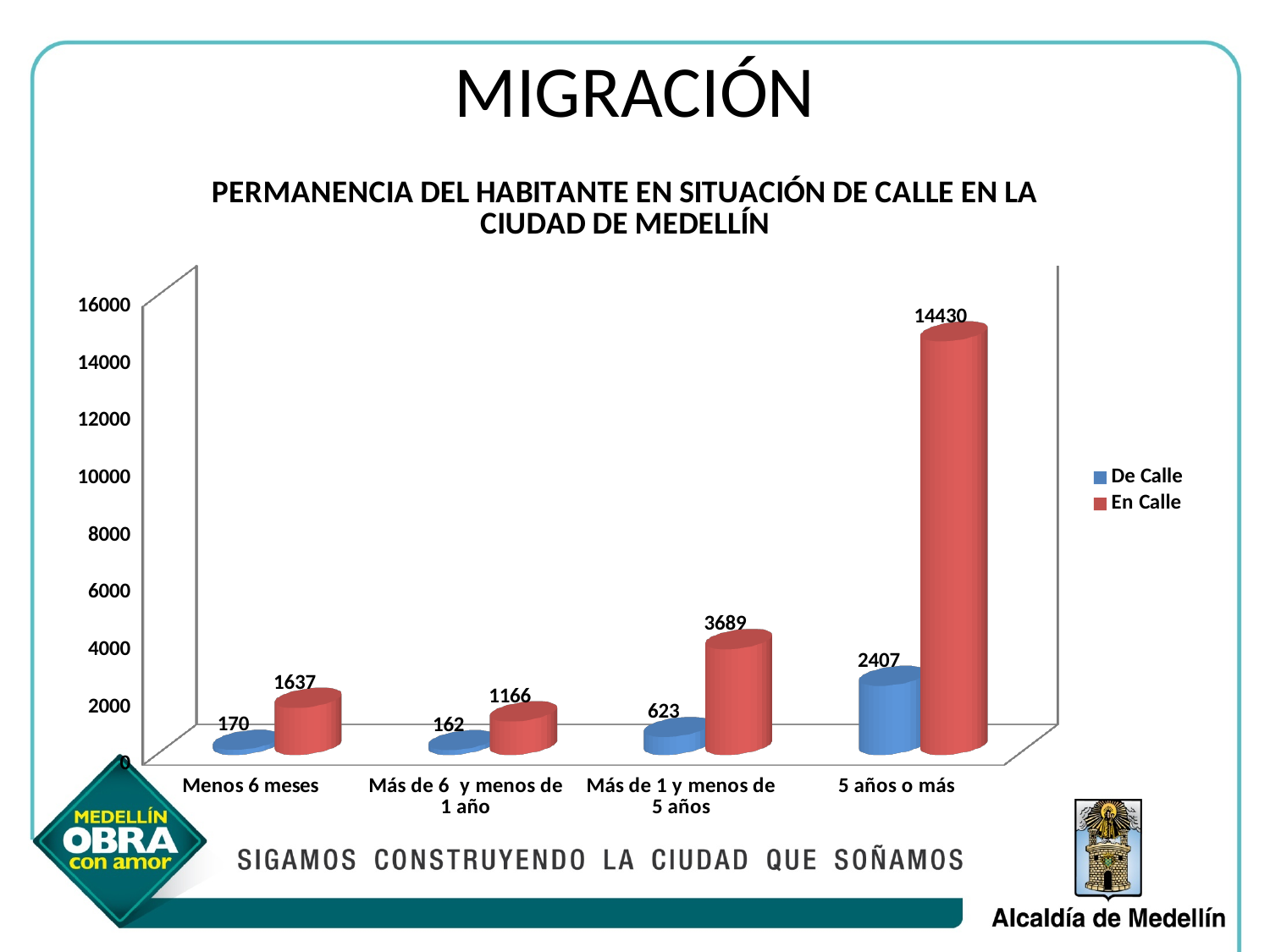
Which category has the lowest "En Calle" value? Más de 6 y menos de 1 año Do the "En Calle" values rise or fall from left to right along the x axis? They fall then rise What is the value for "En Calle" in the "Más de 1 y menos de 5 años" category? 3689 What kind of chart is shown on the slide? Bar chart What colour represents the "En Calle" series? Red What is the difference between the "En Calle" and "De Calle" values for "5 años o más"? 12023 Which category has the highest "De Calle" value? 5 años o más Which is larger: the "De Calle" value for "Menos 6 meses" or for "Más de 6 y menos de 1 año"? Menos 6 meses How many series does the legend list? 2 How many categories are shown on the x axis? 4 What is the value for "En Calle" in the "5 años o más" category? 14430 What is the value for "De Calle" in the "Menos 6 meses" category? 170